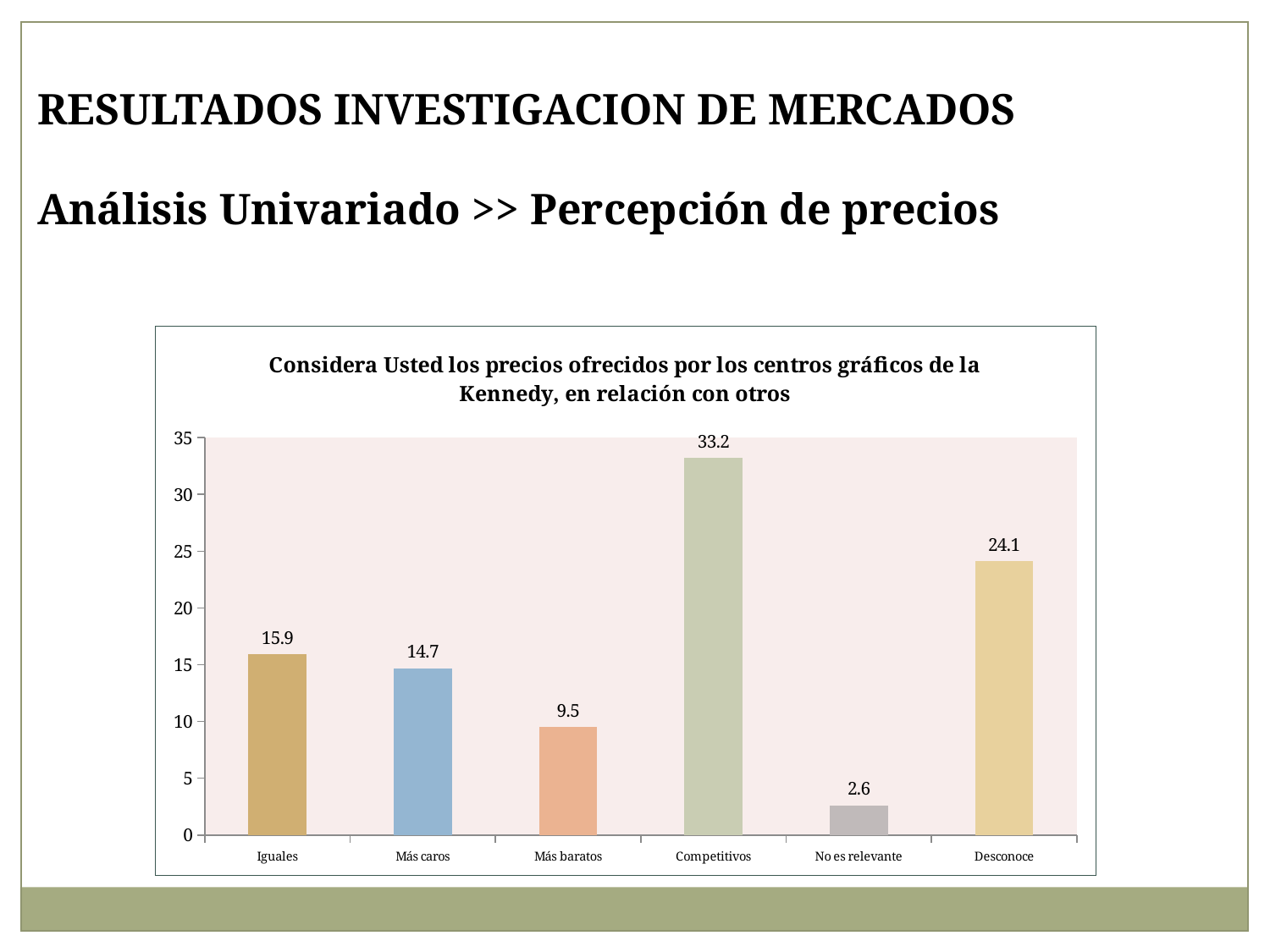
Which category has the highest value? Competitivos What is the difference between the values for Competitivos and Desconoce? 9.1 What is the difference between the values for Iguales and Más caros? 1.2 Is the value for Desconoce greater or less than 20? greater What is the value for Más baratos? 9.5 How many categories are shown on the x axis? 6 What is the value for No es relevante? 2.6 Which category has the lowest value? No es relevante What is the value for Desconoce? 24.1 What kind of chart is shown on the slide? Bar chart What is the value for Competitivos? 33.2 Which is larger, the value for Iguales or the value for Más caros? Iguales